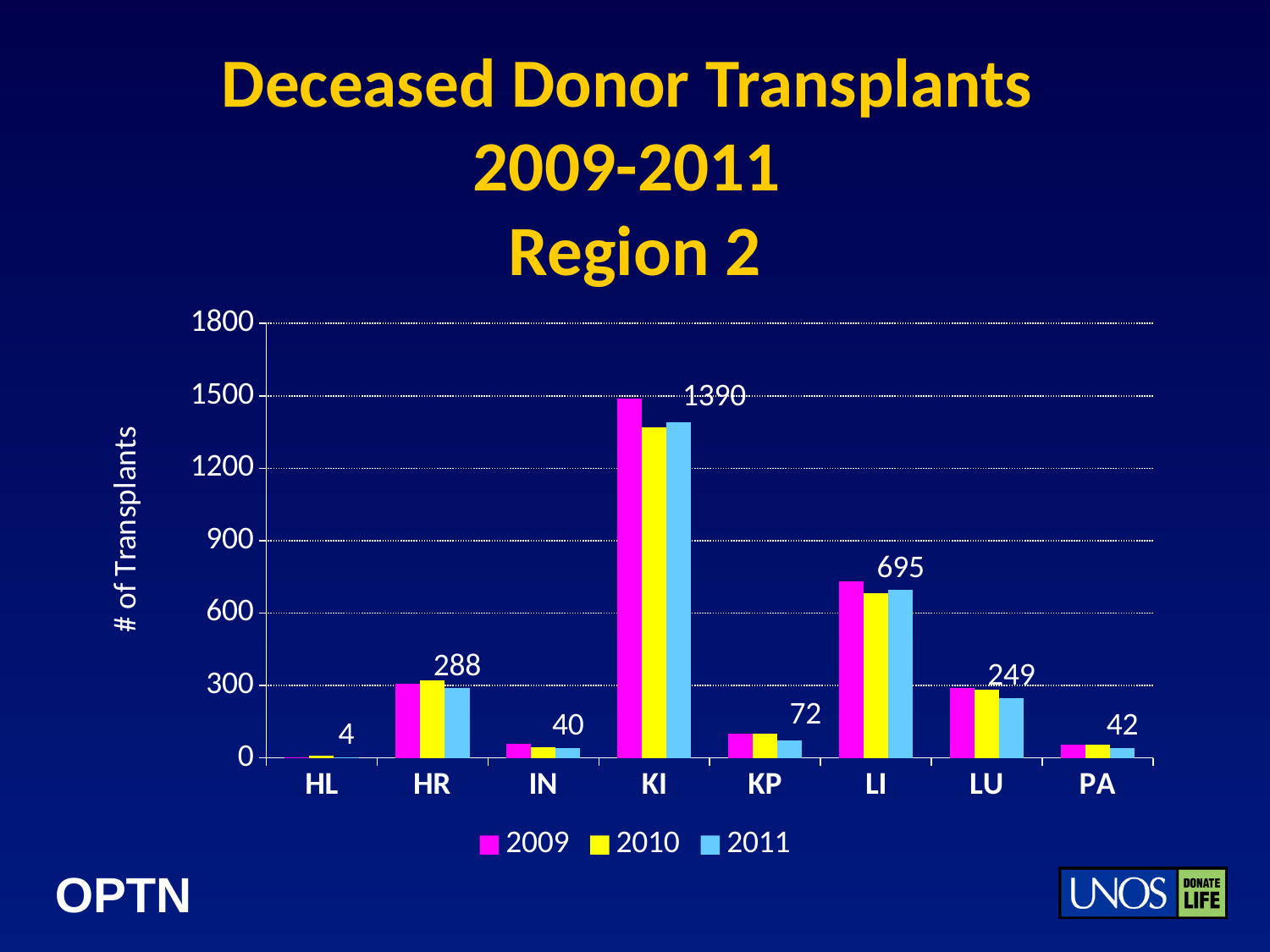
What is the 2011 value for LI? 695 Which is larger in 2011, KP or PA? KP What is the 2011 value for HR? 288 What is the 2011 value for HL? 4 Which organ category has the highest number of transplants? KI How many series does the legend list? 3 What is the difference between the 2011 values for LI and LU? 446 How many organ categories are shown on the x axis? 8 Which organ category has the lowest number of transplants? HL Is the 2009 value for KI greater or less than 1200? greater What kind of chart is shown on the slide? bar chart What is the 2011 value for KI? 1390